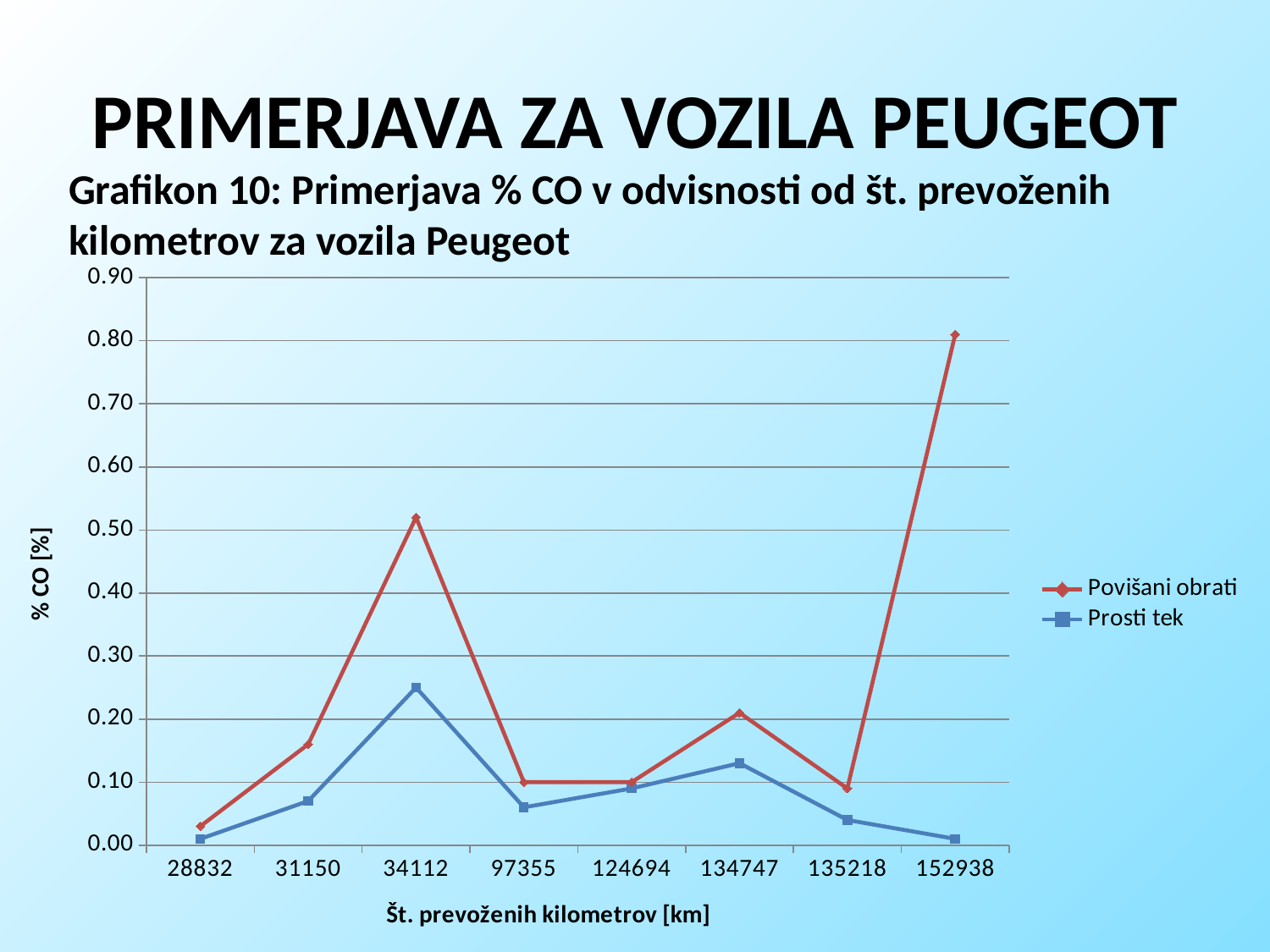
How many kilometre categories are shown on the x axis? 8 What is the label of the y axis? % CO [%] Which series is drawn in red? Povišani obrati How many series does the legend list? 2 Is the value for Povišani obrati at 34112 km greater or less than 0.50? greater What kind of chart is shown on the slide? line chart At which kilometre value does the Prosti tek series reach its highest point? 34112 Does the Prosti tek series rise or fall between 134747 km and 152938 km? fall Is the value for Prosti tek at 34112 km greater or less than 0.30? less At which kilometre value does the Povišani obrati series reach its highest point? 152938 At 134747 km, which series has the higher value, Povišani obrati or Prosti tek? Povišani obrati